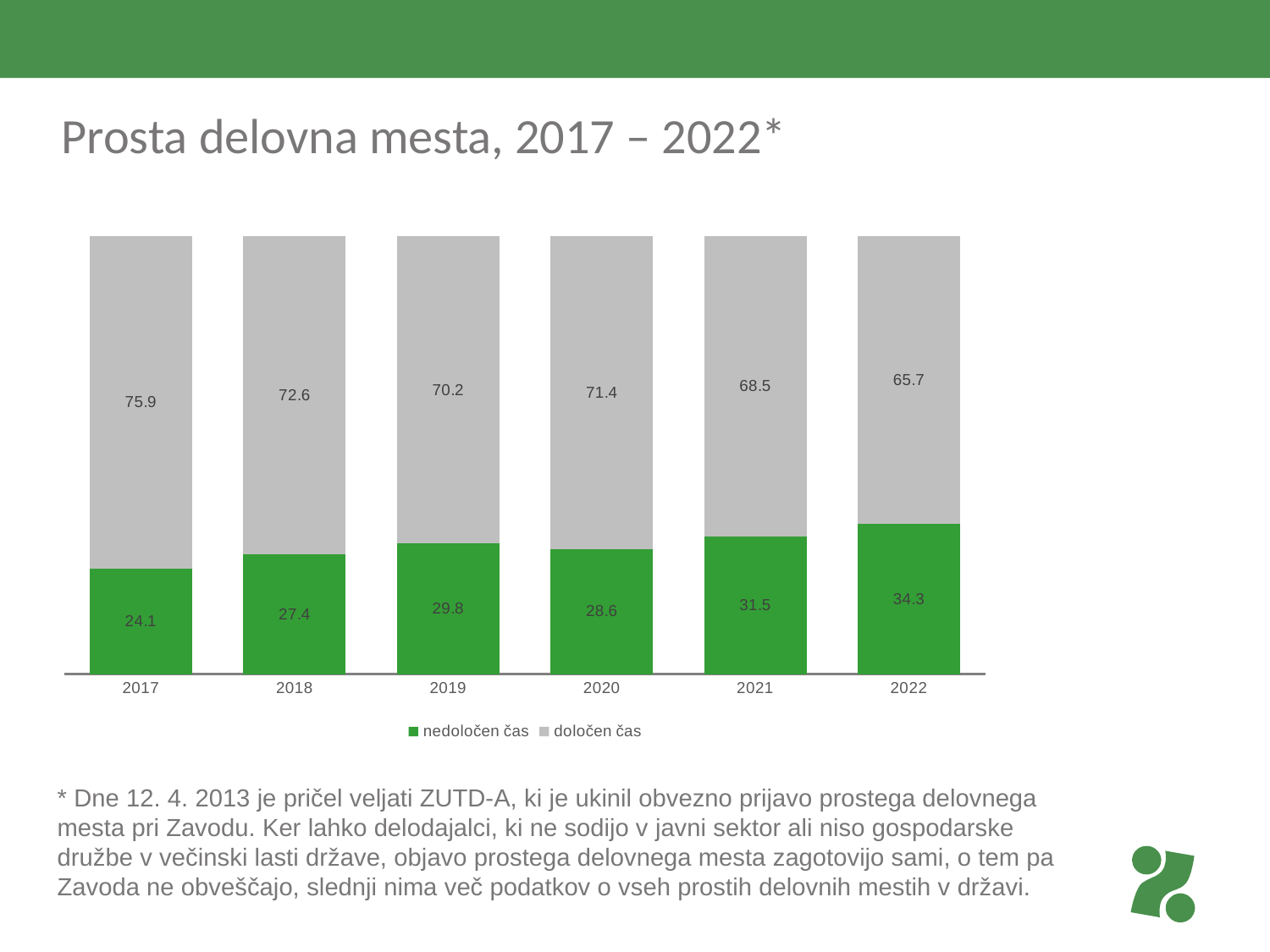
What is the value for 'določen čas' in 2022? 65.7 What is the difference between the 'določen čas' values for 2017 and 2022? 10.2 Does the 'določen čas' value generally rise or fall from 2017 to 2022? Fall What kind of chart is shown on the slide? Stacked bar chart Which is larger: the 'nedoločen čas' value for 2019 or for 2020? 2019 How many series does the legend list? 2 How many years are shown on the x axis? 6 Which year has the lowest value for 'določen čas'? 2022 What is the value for 'nedoločen čas' in 2017? 24.1 Which year has the highest value for 'nedoločen čas'? 2022 What is the value for 'nedoločen čas' in 2020? 28.6 What is the total of the stacked bar for 2021? 100